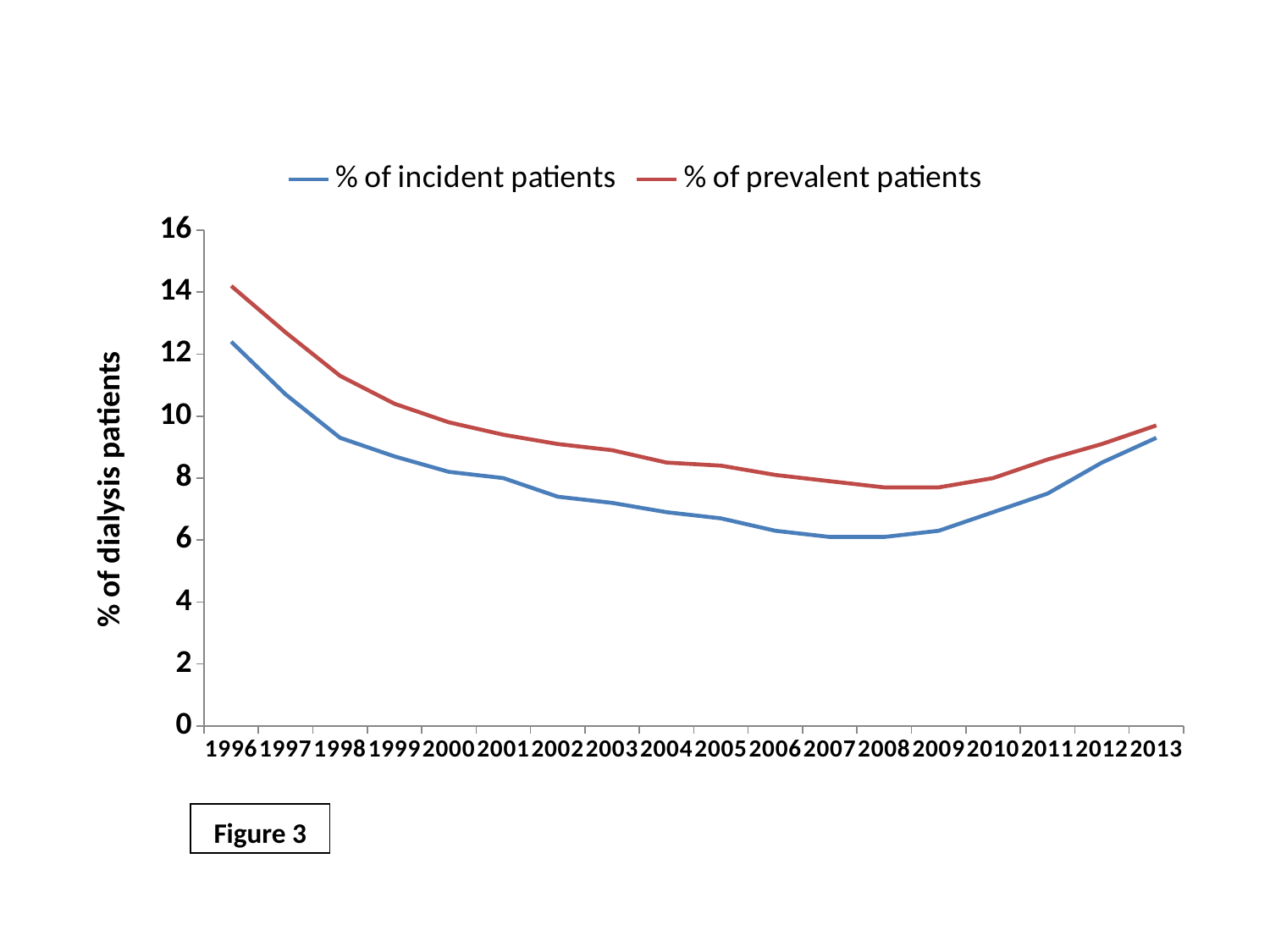
What is the title of the y axis? % of dialysis patients What kind of chart is shown on the slide? line chart How many series does the legend list? 2 How many years are plotted along the x axis? 18 Is the value for % of prevalent patients in 2008 greater or less than 10? less Does the % of incident patients rise or fall from 1996 to 2008? fall In which year is the % of prevalent patients highest? 1996 Which series is drawn in red? % of prevalent patients Is the value for % of incident patients in 2007 greater or less than 8? less In which year is the % of incident patients highest? 1996 Is the value for % of incident patients in 1996 greater or less than 10? greater In 2005, which is larger: % of incident patients or % of prevalent patients? % of prevalent patients